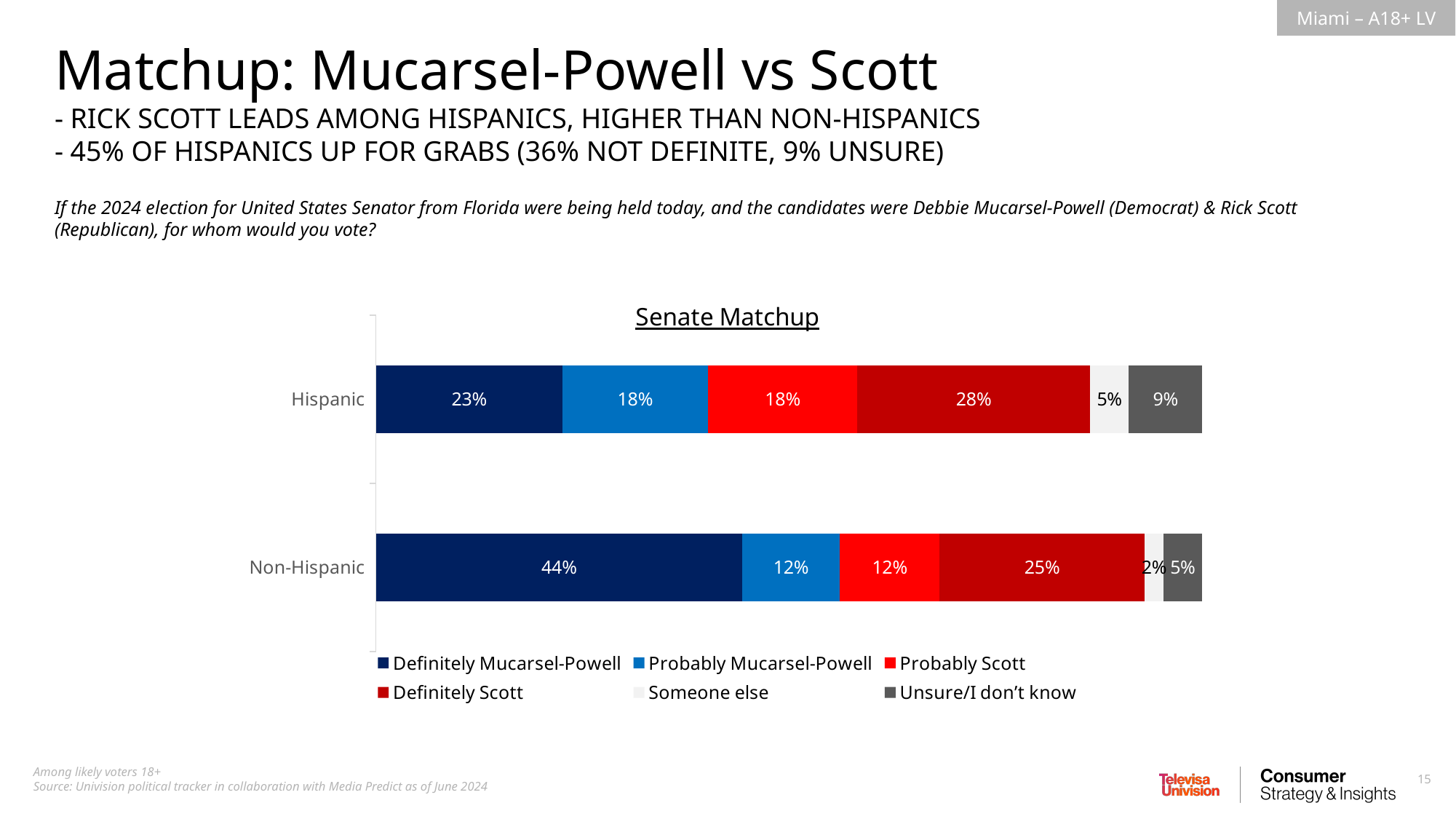
Which segment is the largest in the Non-Hispanic bar? Definitely Mucarsel-Powell What is the Definitely Scott value for the Hispanic bar? 28% How many categories are shown on the chart? 2 What is the difference between the Definitely Mucarsel-Powell values for Non-Hispanic and Hispanic voters? 21 percentage points What percentage of Hispanic likely voters say they would definitely vote for Mucarsel-Powell? 23% What percentage of Non-Hispanic likely voters say they would definitely vote for Mucarsel-Powell? 44% Which group has a higher Definitely Scott value, Hispanic or Non-Hispanic? Hispanic What kind of chart is shown on the slide? Stacked bar chart How many series does the legend list? 6 What is the Unsure/I don't know value for the Non-Hispanic bar? 5% What is the Someone else value for the Hispanic bar? 5% Which segment is the smallest in the Non-Hispanic bar? Someone else